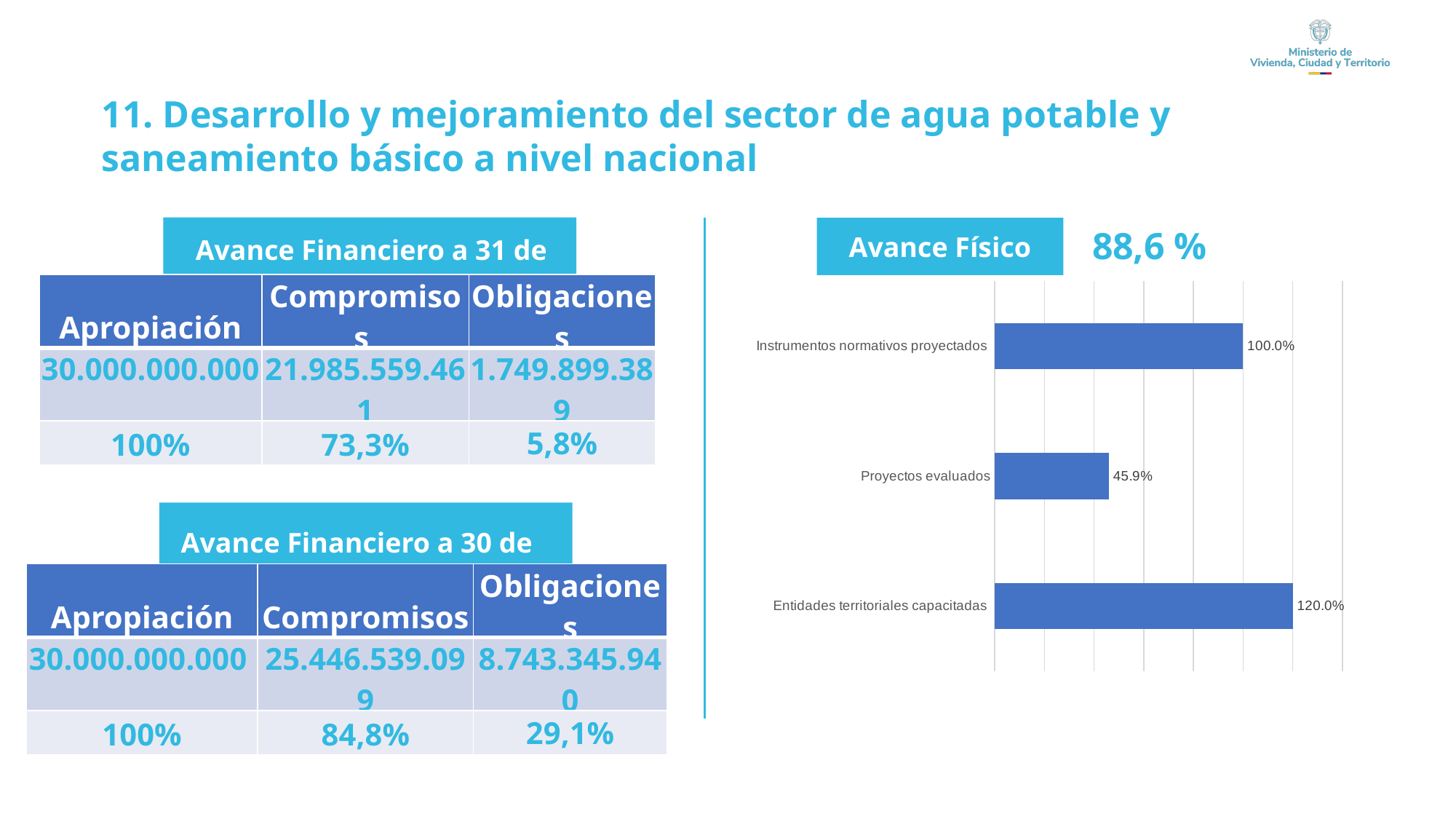
What is the difference between the values for Entidades territoriales capacitadas and Proyectos evaluados? 74.1% What is the value for Proyectos evaluados? 45.9% What is the difference between the values for Instrumentos normativos proyectados and Proyectos evaluados? 54.1% Which is larger, the value for Proyectos evaluados or the value for Instrumentos normativos proyectados? Instrumentos normativos proyectados What is the title shown above the chart? Avance Físico What is the value for Instrumentos normativos proyectados? 100.0% Which category has the highest value in the chart? Entidades territoriales capacitadas How many categories are shown in the chart? 3 What is the value for Entidades territoriales capacitadas? 120.0% What is the difference between the values for Entidades territoriales capacitadas and Instrumentos normativos proyectados? 20.0% Which category has the lowest value in the chart? Proyectos evaluados What kind of chart is shown on the slide? Bar chart